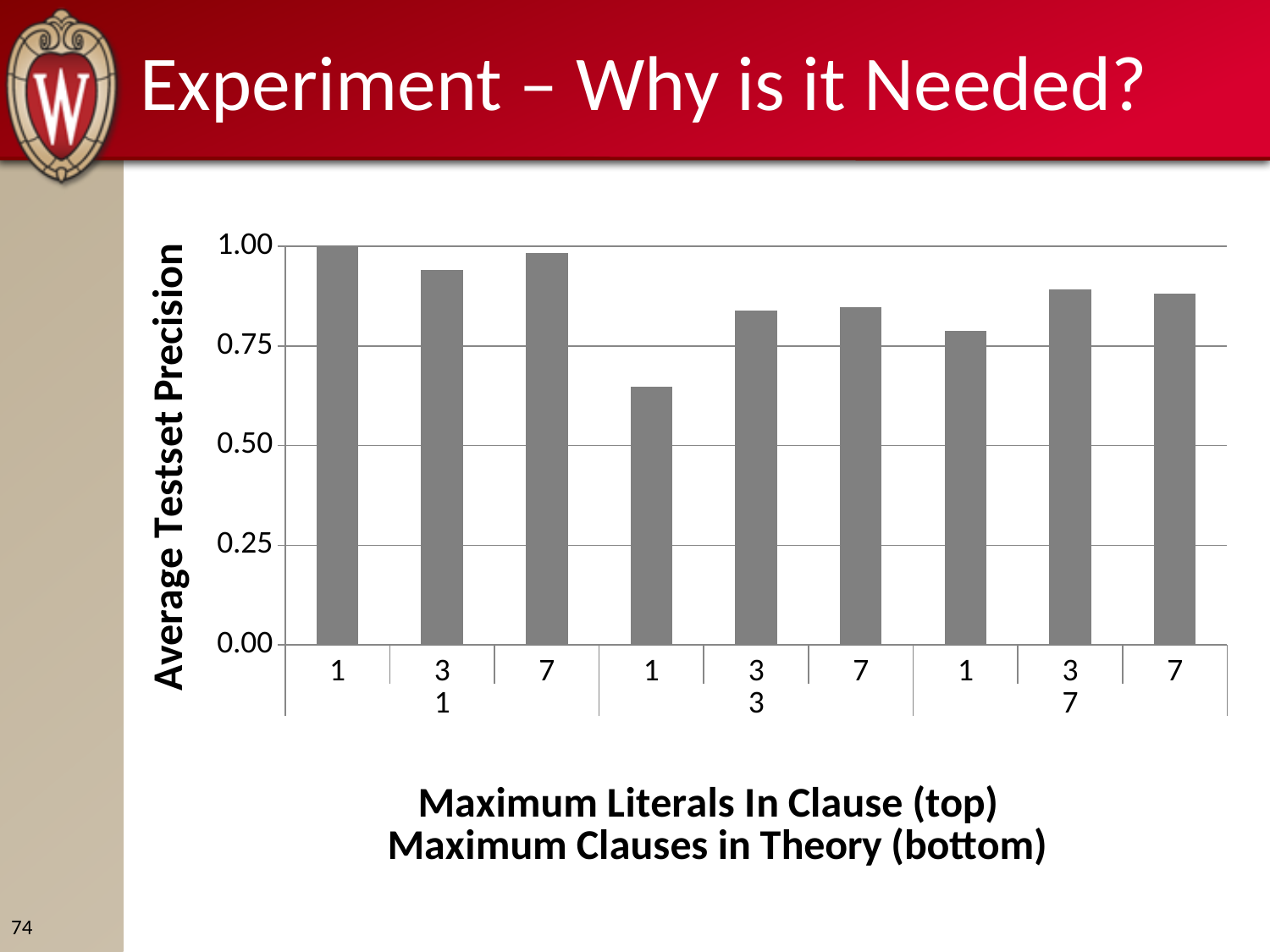
What does the bottom row of x-axis labels represent? Maximum Clauses in Theory Which is larger: the value for 3 literals with 1 clause or 3 literals with 3 clauses? 3 literals with 1 clause Within the group with 3 maximum clauses, do the values rise or fall as the maximum literals increase from 1 to 7? rise What is the title of the vertical axis? Average Testset Precision Is the value for 3 literals with 1 clause greater or less than 0.75? greater Is the value for 1 literal with 3 clauses greater or less than 0.75? less Is the value for 1 literal with 3 clauses greater or less than 0.50? greater Which is larger: the value for 1 literal with 3 clauses or 1 literal with 7 clauses? 1 literal with 7 clauses Which bar has the lowest average testset precision? 1 literal, 3 clauses How many bars are plotted in the chart? 9 What kind of chart is shown on the slide? bar chart